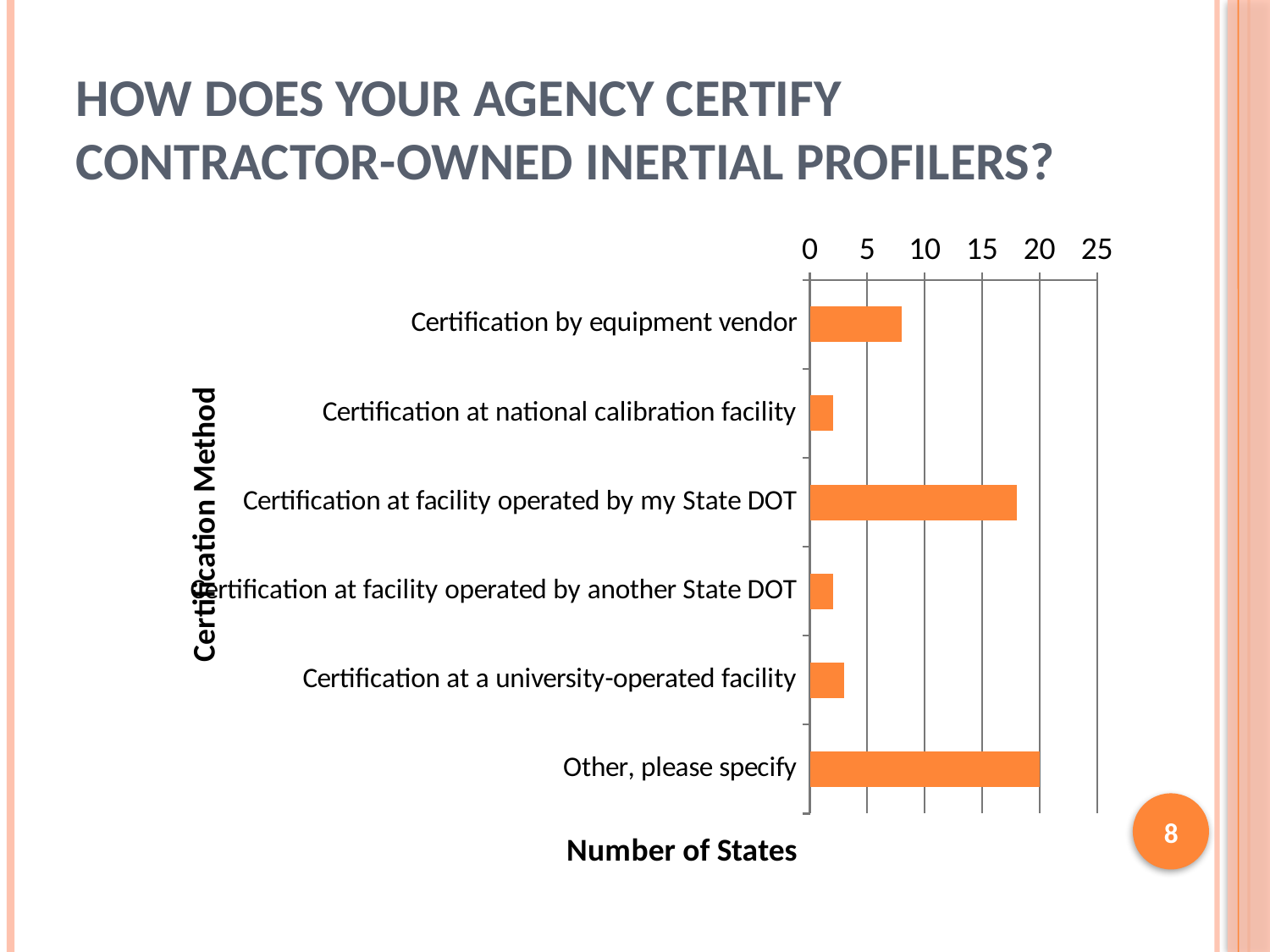
Is the value for "Certification at national calibration facility" greater or less than 5? less Is the value for "Certification at facility operated by my State DOT" greater or less than 15? greater Which certification method has the highest number of states? Other, please specify Is the value for "Certification at a university-operated facility" greater or less than 5? less What is the title of the horizontal axis? Number of States What is the number of states for "Other, please specify"? 20 What kind of chart is shown on the slide? bar chart How many certification methods are listed on the chart? 6 What is the title of the vertical axis? Certification Method Which has more states: "Certification at facility operated by my State DOT" or "Certification by equipment vendor"? Certification at facility operated by my State DOT